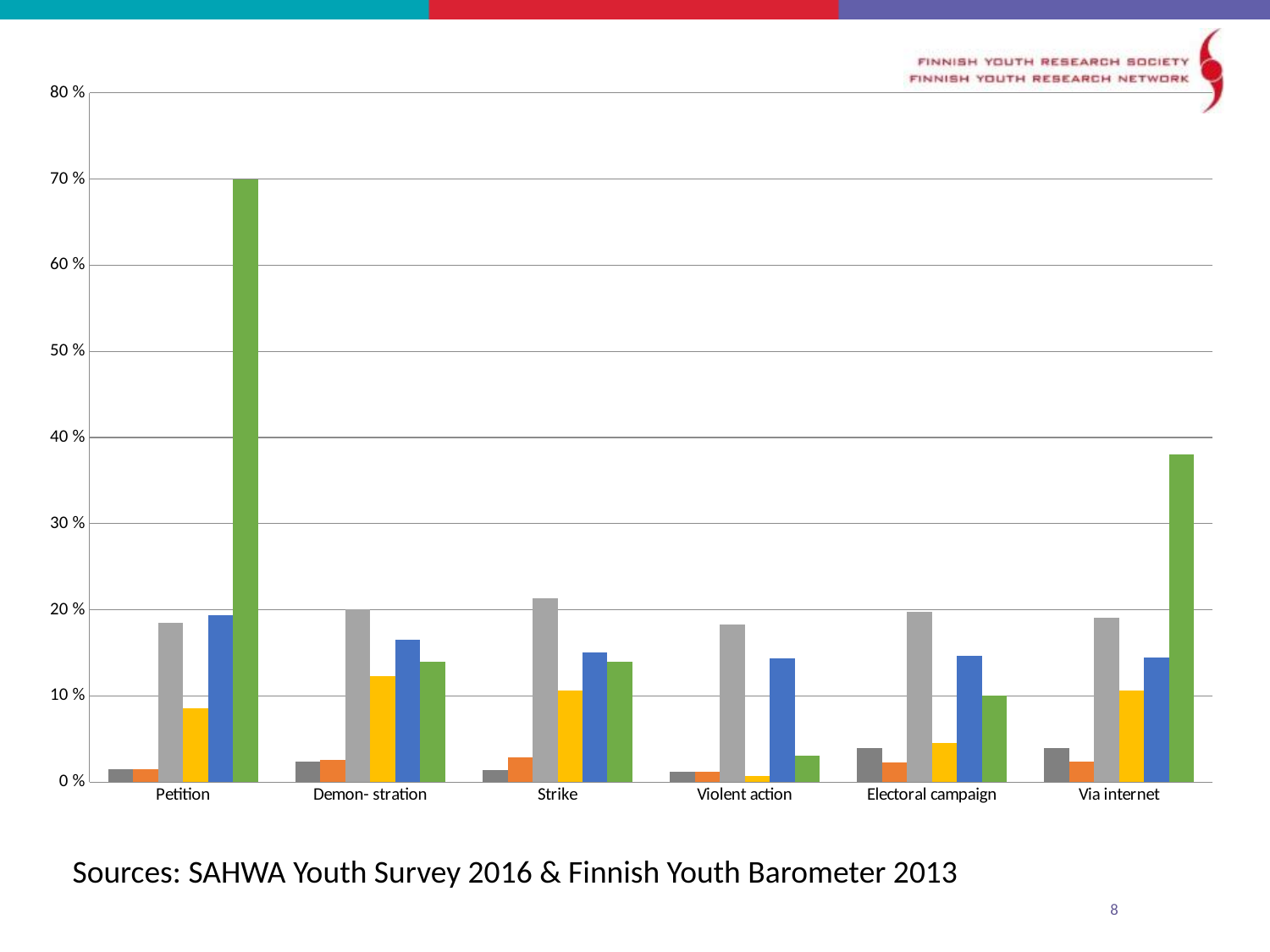
Is the green bar for Via internet greater or less than 30%? greater Which category contains the tallest bar in the chart? Petition Is the blue bar for Petition greater or less than 10%? greater What is the highest value shown on the y axis? 80 % Among the green bars, which category has the lowest value? Violent action Is the green bar for Violent action greater or less than 10%? less Which is larger: the green bar for Petition or the green bar for Via internet? Petition What kind of chart is shown on the slide? bar chart Within the Via internet category, which is larger: the green bar or the blue bar? the green bar How many categories are shown along the x axis? 6